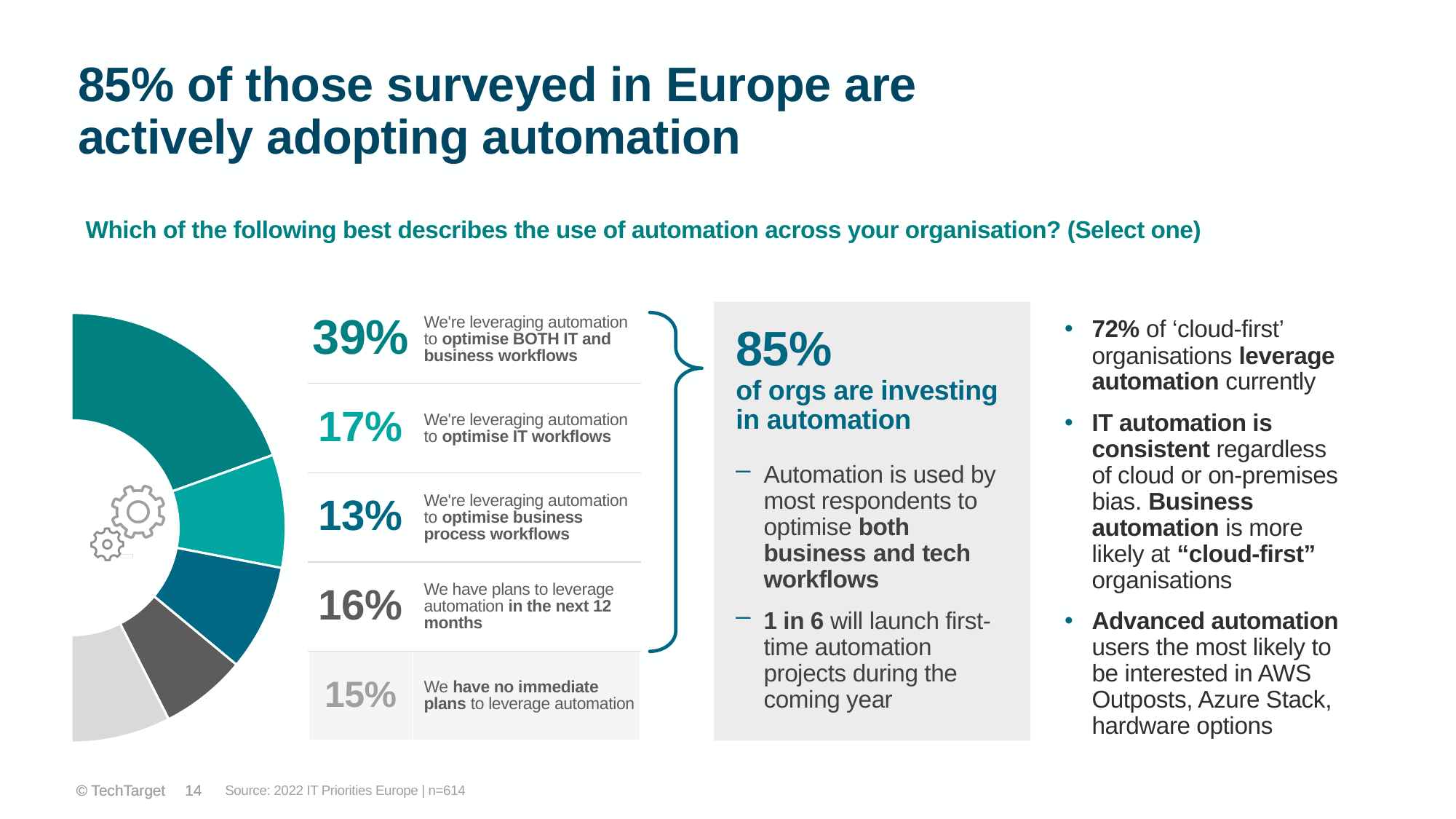
What percentage of respondents are leveraging automation to optimise IT workflows? 17% According to the slide, what combined percentage of organisations are investing in automation? 85% What is the difference in percentage points between those optimising BOTH IT and business workflows and those optimising IT workflows only? 22 percentage points Which response category has the largest share of the doughnut chart? We're leveraging automation to optimise BOTH IT and business workflows What percentage of respondents are leveraging automation to optimise business process workflows? 13% Which response category has the smallest share of the doughnut chart? We're leveraging automation to optimise business process workflows What percentage of respondents are leveraging automation to optimise BOTH IT and business workflows? 39% Which is larger: the share with plans to leverage automation in the next 12 months, or the share with no immediate plans? Plans to leverage automation in the next 12 months (16%) What percentage of respondents have no immediate plans to leverage automation? 15% What percentage of respondents have plans to leverage automation in the next 12 months? 16% What kind of chart is shown on the left of the slide? Doughnut chart How many segments does the doughnut chart have? 5